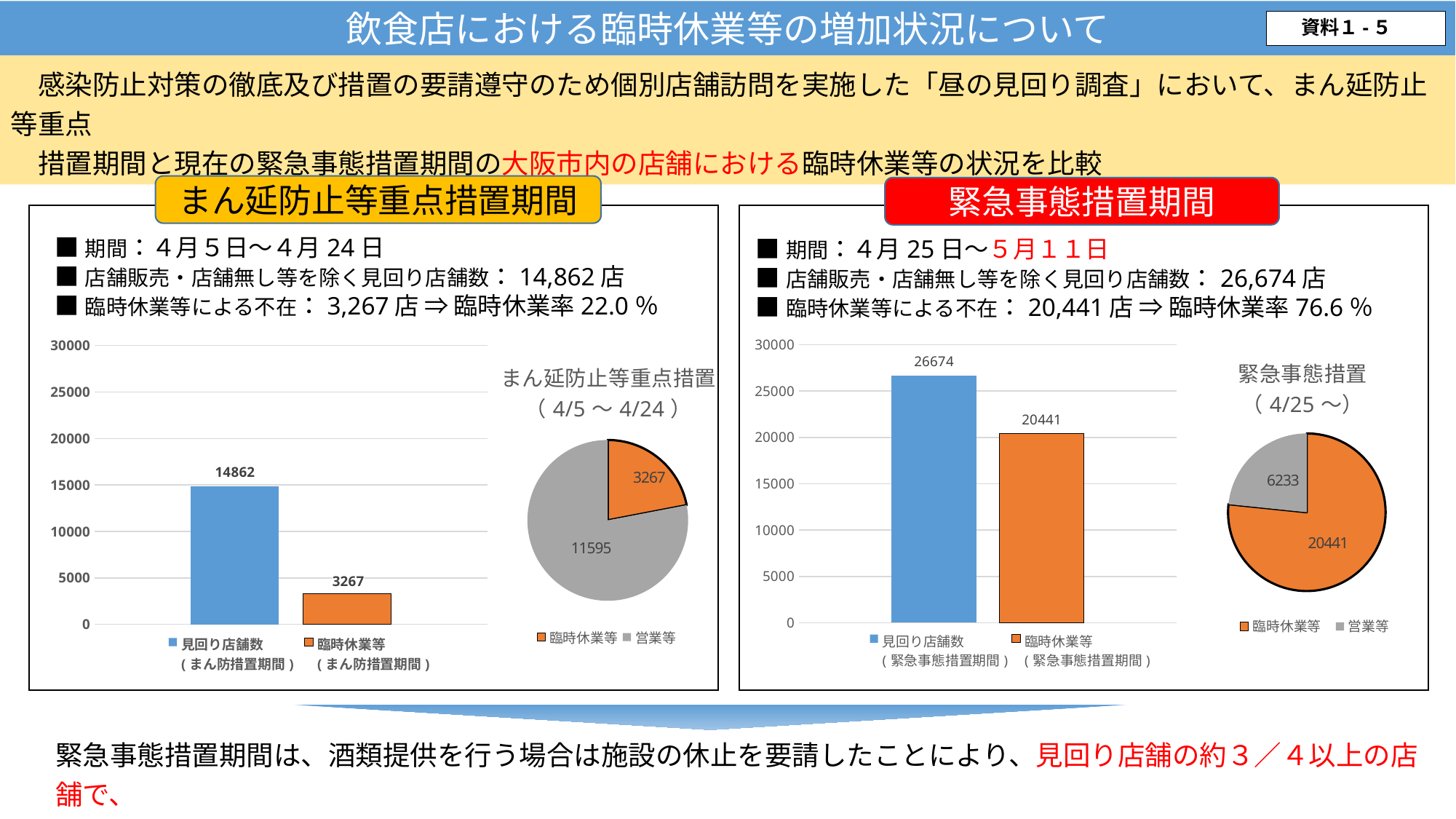
In the bar chart on the left (まん延防止等重点措置期間), what is the value for 見回り店舗数? 14862 In the pie chart on the right (緊急事態措置 4/25～), what is the value of the 営業等 slice? 6233 In the bar chart on the right (緊急事態措置期間), what is the difference between 見回り店舗数 and 臨時休業等? 6233 How many entries does the legend of the pie chart on the left (まん延防止等重点措置 4/5～4/24) list? 2 In the bar chart on the right (緊急事態措置期間), what is the value for 臨時休業等? 20441 In the pie chart on the left (まん延防止等重点措置 4/5～4/24), what is the value of the 営業等 slice? 11595 In the bar chart on the right (緊急事態措置期間), what is the value for 見回り店舗数? 26674 What type of chart is the chart titled 緊急事態措置 (4/25～) on the right side of the slide? pie chart In the pie chart on the right (緊急事態措置 4/25～), which slice is larger, 臨時休業等 or 営業等? 臨時休業等 In the bar chart on the left (まん延防止等重点措置期間), what is the value for 臨時休業等? 3267 In the pie chart on the left (まん延防止等重点措置 4/5～4/24), which slice is the largest? 営業等 In the bar chart on the left (まん延防止等重点措置期間), what is the difference between 見回り店舗数 and 臨時休業等? 11595